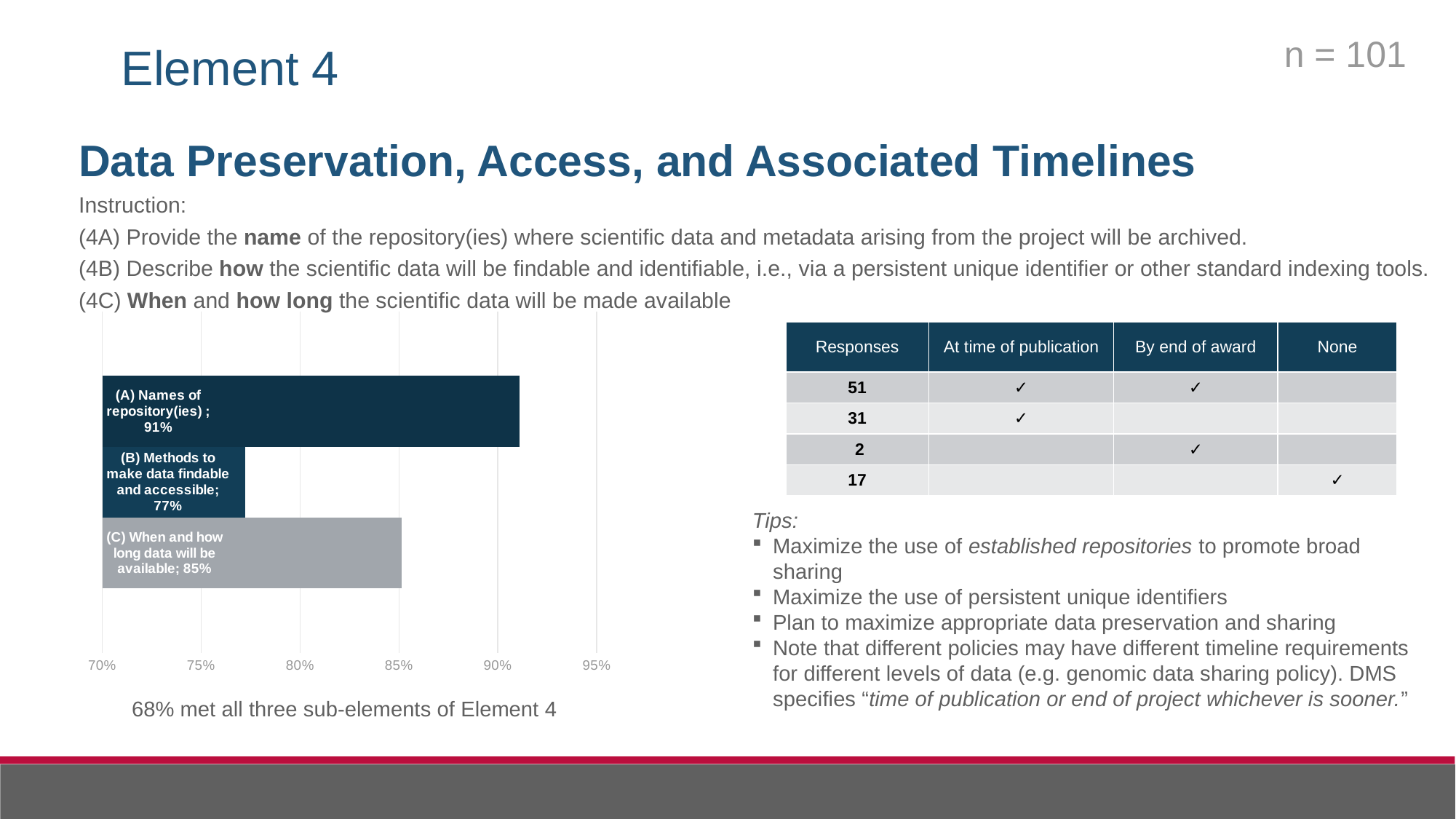
What is the lowest value shown on the chart's horizontal axis? 70% What is the value for (A) Names of repository(ies)? 91% What is the value for (B) Methods to make data findable and accessible? 77% Which sub-element has the highest value? (A) Names of repository(ies) Which sub-element has the lowest value? (B) Methods to make data findable and accessible Is the value for (A) Names of repository(ies) greater or less than 90%? greater Which is larger, the value for (C) When and how long data will be available or the value for (B) Methods to make data findable and accessible? (C) When and how long data will be available What kind of chart is shown on the slide? bar chart How many bars does the chart show? 3 What is the difference between the values for (A) Names of repository(ies) and (B) Methods to make data findable and accessible? 14% What is the value for (C) When and how long data will be available? 85% What is the difference between the values for (C) When and how long data will be available and (B) Methods to make data findable and accessible? 8%